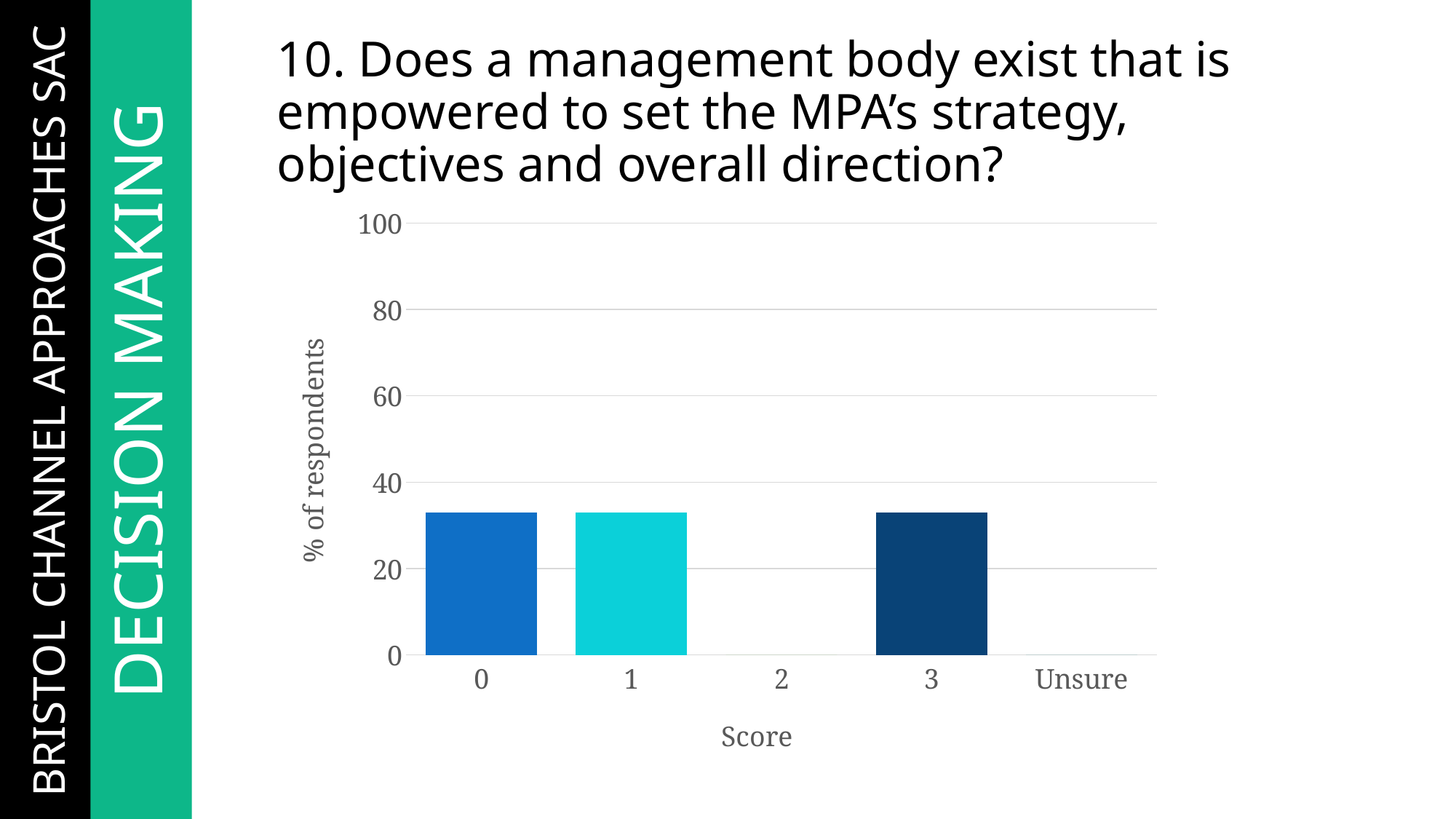
Is the value for score 1 greater or less than 40? less Is the value for score 3 greater or less than 20? greater What is the label of the x axis? Score Is the value for score 0 greater or less than 20? greater What kind of chart is shown on the slide? bar chart How many score categories are shown on the x axis? 5 Which score categories have no bar shown (0% of respondents)? 2 and Unsure What is the label of the y axis? % of respondents